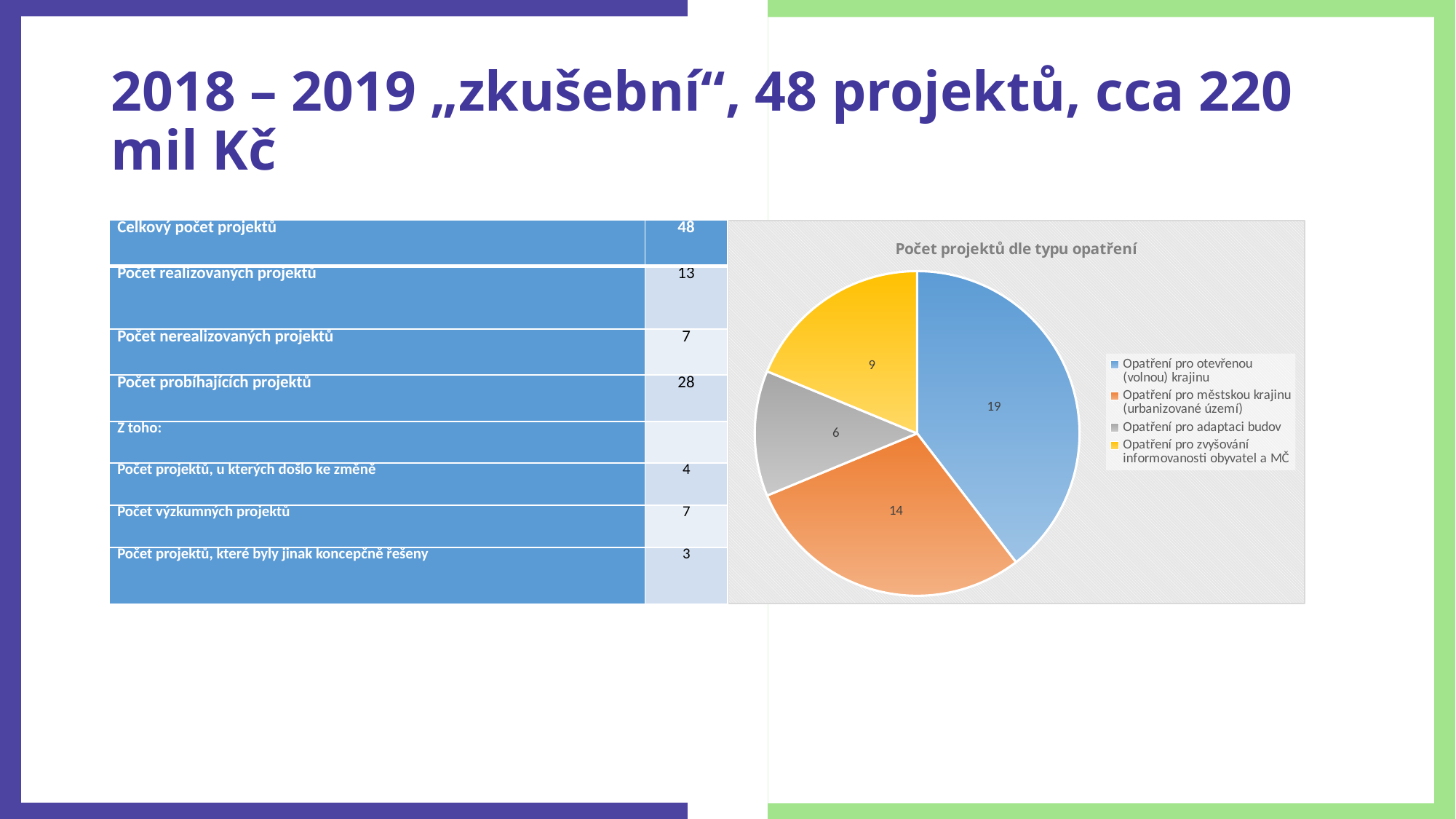
What is the value for Opatření pro zvyšování informovanosti obyvatel a MČ? 9 How many entries does the chart legend list? 4 How many slices does the pie chart have? 4 What share of the pie does Opatření pro adaptaci budov represent? 12.5% What is the value for Opatření pro otevřenou (volnou) krajinu? 19 Which category has the smallest slice of the pie? Opatření pro adaptaci budov What is the difference between the values for Opatření pro otevřenou (volnou) krajinu and Opatření pro městskou krajinu (urbanizované území)? 5 What is the title of the chart? Počet projektů dle typu opatření What is the value for Opatření pro adaptaci budov? 6 What type of chart is shown on the slide? pie chart What is the value for Opatření pro městskou krajinu (urbanizované území)? 14 Which category has the largest slice of the pie? Opatření pro otevřenou (volnou) krajinu